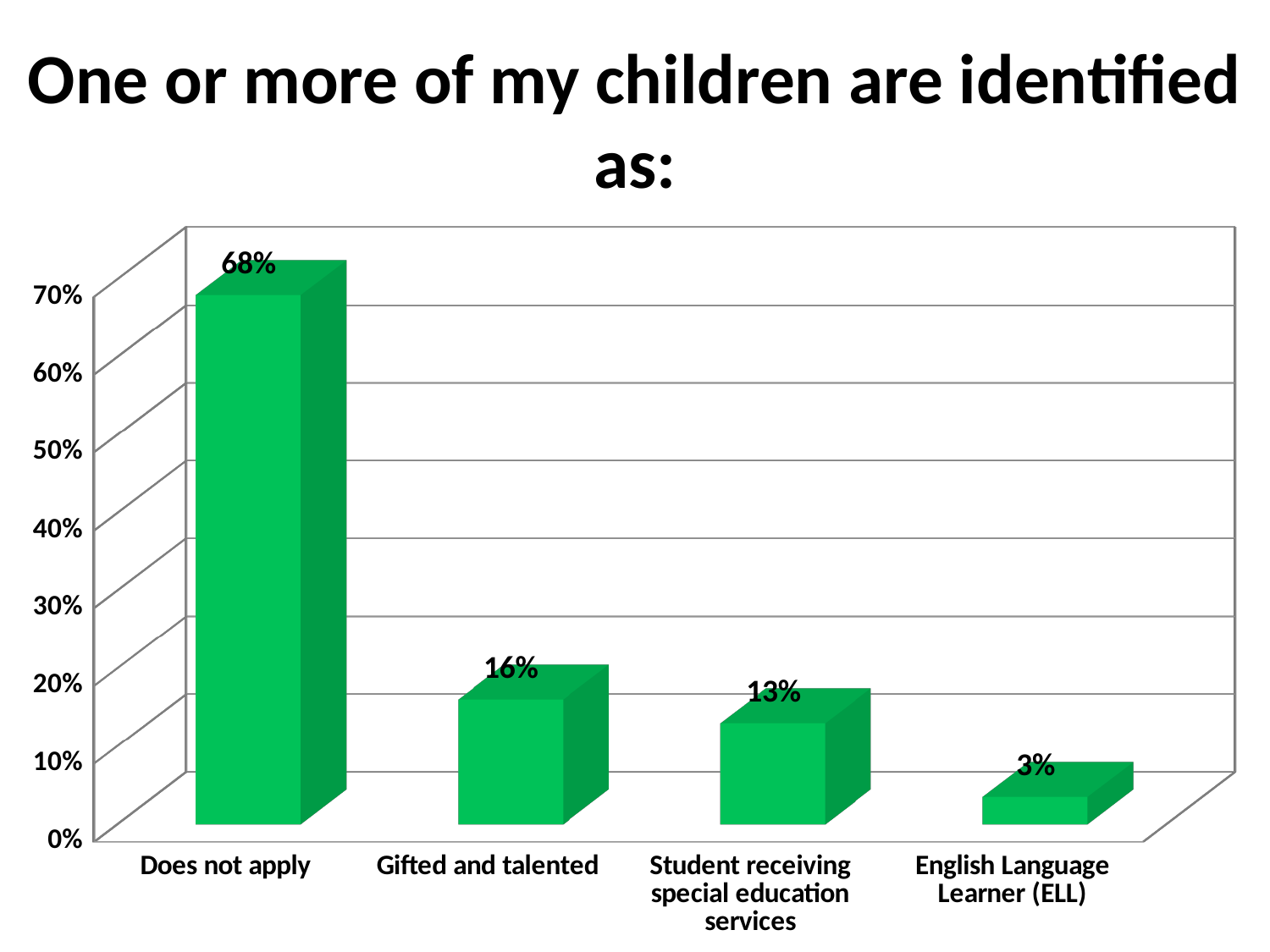
What percentage is shown for "English Language Learner (ELL)"? 3% What percentage is shown for "Gifted and talented"? 16% Which category has the lowest value? English Language Learner (ELL) Which is larger: the value for "Gifted and talented" or the value for "English Language Learner (ELL)"? Gifted and talented What percentage is shown for "Student receiving special education services"? 13% Is the value for "Does not apply" greater or less than 60%? greater What is the difference between the values for "Gifted and talented" and "Student receiving special education services"? 3% What percentage is shown for "Does not apply"? 68% What is the difference between the values for "Does not apply" and "Gifted and talented"? 52% How many categories are shown on the chart? 4 What kind of chart is shown on the slide? Bar chart Which category has the highest value? Does not apply